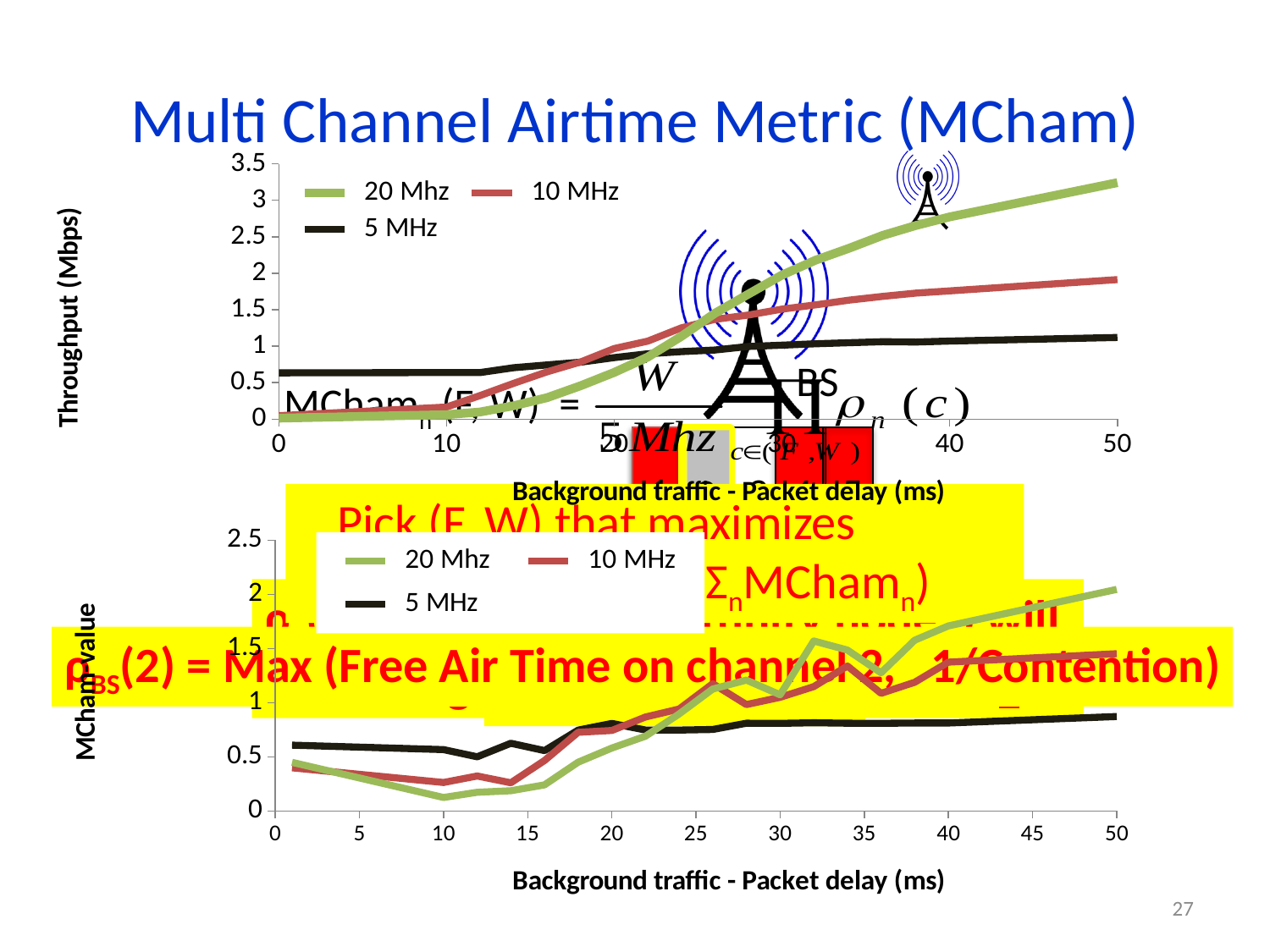
How many series does the legend of the top chart list? 3 In the top chart, which series has the highest throughput at a packet delay of 50 ms? 20 Mhz In the top chart, does the throughput of the 20 Mhz series rise or fall as packet delay increases? rise What kind of chart is the top chart (Throughput vs Background traffic)? line chart In the top chart, which series has the highest throughput at a packet delay of 0 ms? 5 MHz In the top chart, is the throughput of the 10 MHz series at 50 ms greater or less than 2? less In the bottom chart, which series has the lowest MCham-value at a packet delay of 10 ms? 20 Mhz In the bottom chart, is the MCham-value of the 20 Mhz series at 50 ms greater or less than 1.5? greater In the top chart, is the throughput of the 20 Mhz series at 50 ms greater or less than 3? greater What is the y-axis title of the bottom chart? MCham-value In the top chart, which series has the lowest throughput at a packet delay of 50 ms? 5 MHz